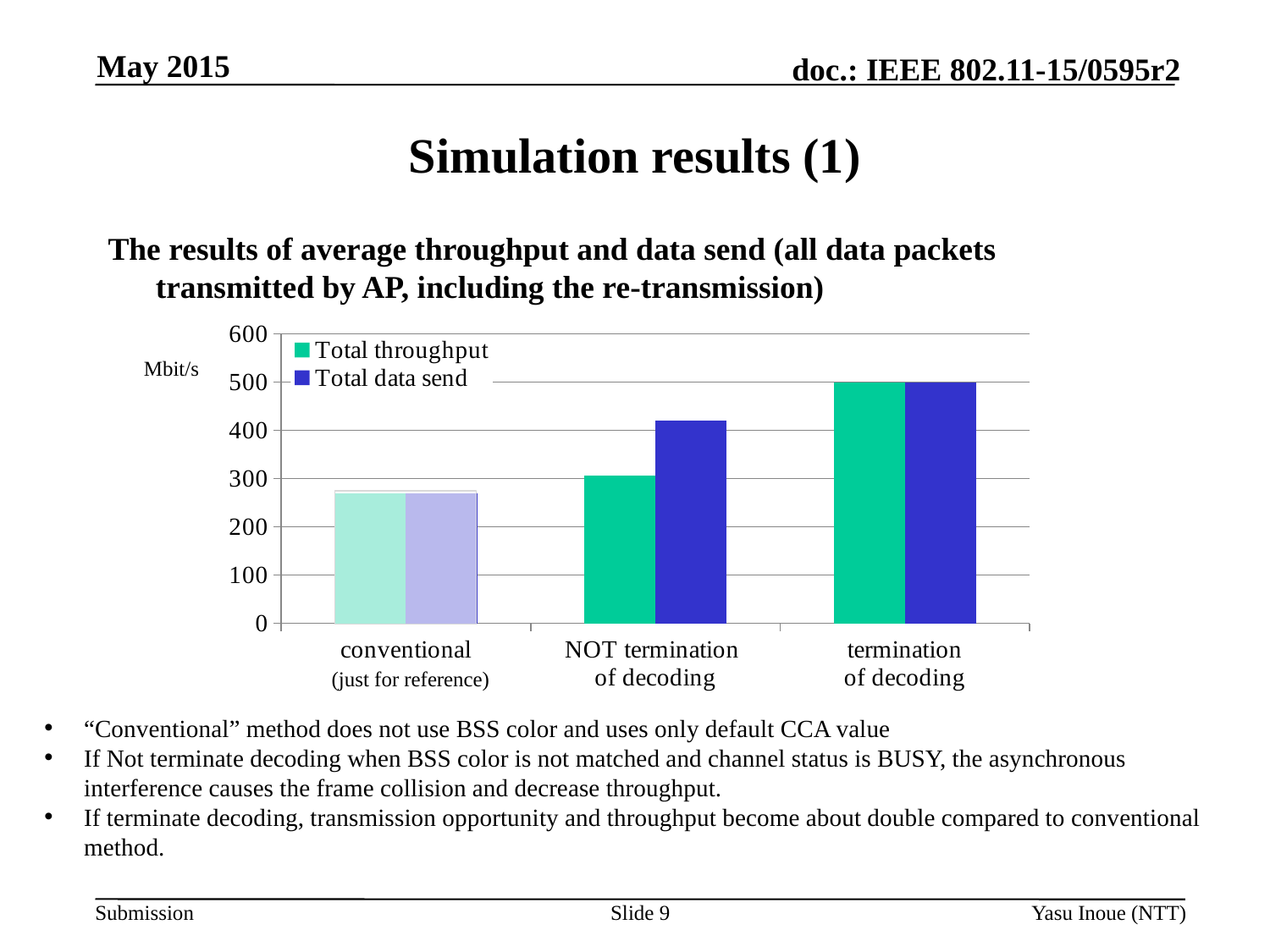
What kind of chart is shown on the slide? bar chart Is the Total throughput value for NOT termination of decoding greater or less than 400? less How many categories are shown on the x axis? 3 For NOT termination of decoding, which is larger: Total throughput or Total data send? Total data send Does Total data send rise or fall moving from conventional to termination of decoding along the x axis? rises How many series does the legend list? 2 Is the Total data send value for NOT termination of decoding greater or less than 400? greater Is the Total throughput value for conventional greater or less than 300? less What are the two entries in the legend? Total throughput, Total data send What unit is shown on the y axis? Mbit/s Which category has the highest Total data send? termination of decoding Which category has the lowest Total throughput? conventional